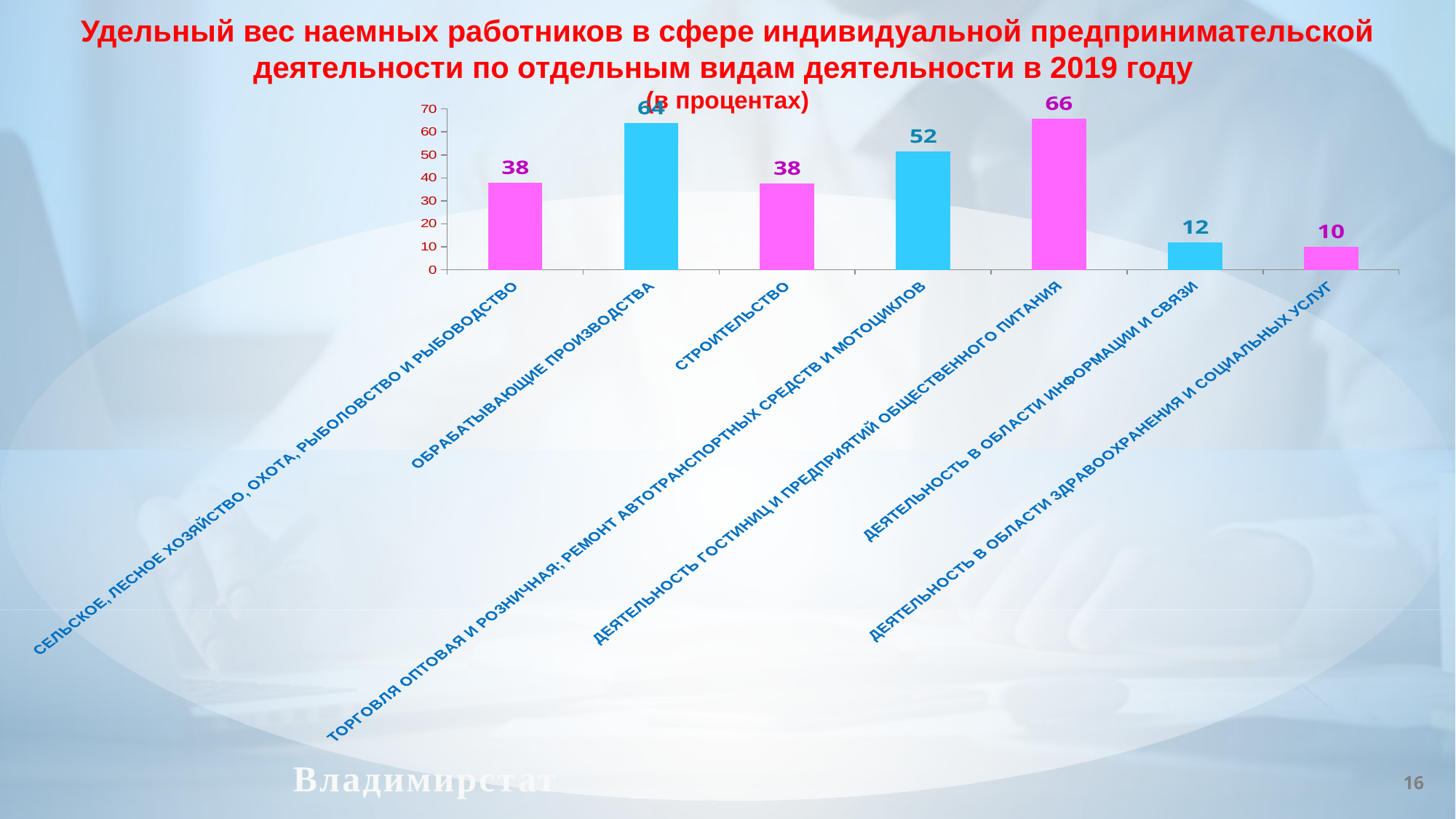
What is the value for Деятельность в области информации и связи? 12 What is the value for Торговля оптовая и розничная; ремонт автотранспортных средств и мотоциклов? 52 How many categories (types of activity) are shown in the chart? 7 Which type of activity has the highest value? Деятельность гостиниц и предприятий общественного питания What is the difference between the values for Деятельность гостиниц и предприятий общественного питания and Обрабатывающие производства? 2 What type of chart is shown on the slide? Bar chart What is the highest value shown on the vertical axis of the chart? 70 What is the value for Обрабатывающие производства? 64 Is the value for Строительство greater or less than 40? less Which is larger: the value for Строительство or the value for Деятельность в области информации и связи? Строительство Which type of activity has the lowest value? Деятельность в области здравоохранения и социальных услуг What is the difference between the values for Обрабатывающие производства and Торговля оптовая и розничная; ремонт автотранспортных средств и мотоциклов? 12